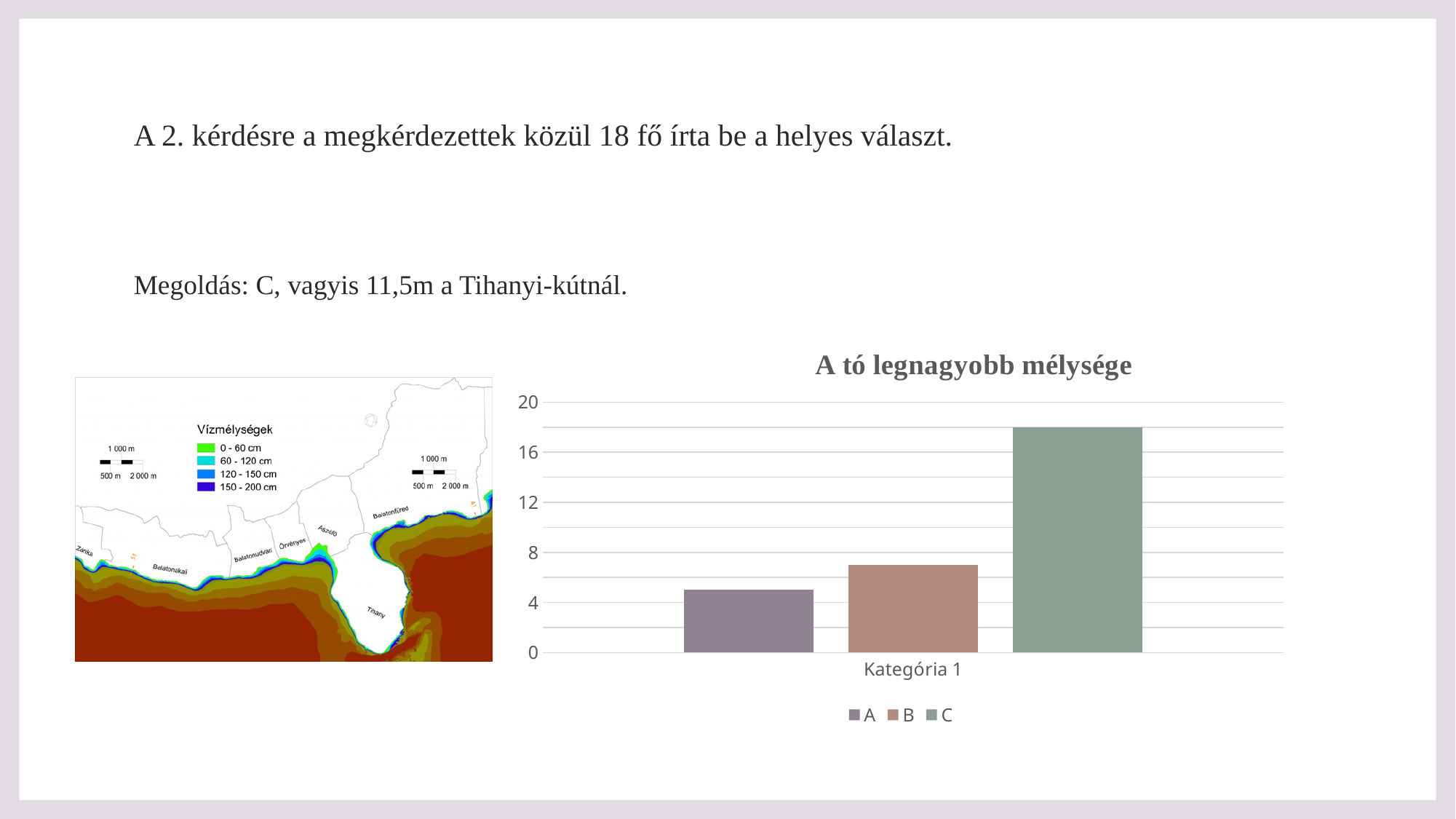
In the chart 'A tó legnagyobb mélysége', is the value for A greater or less than 8? less In the chart 'A tó legnagyobb mélysége', which is larger, the value for A or the value for B? B In the chart 'A tó legnagyobb mélysége', is the value for B greater or less than 4? greater In the chart 'A tó legnagyobb mélysége', is the value for C greater or less than 20? less How many categories are shown on the x axis of the chart 'A tó legnagyobb mélysége'? 1 What kind of chart is 'A tó legnagyobb mélysége'? bar chart What is the label of the category on the x axis of the chart 'A tó legnagyobb mélysége'? Kategória 1 In the chart 'A tó legnagyobb mélysége', which series has the lowest bar? A How many series does the legend of the chart 'A tó legnagyobb mélysége' list? 3 In the chart 'A tó legnagyobb mélysége', which series has the highest bar? C What is the title of the bar chart on the slide? A tó legnagyobb mélysége